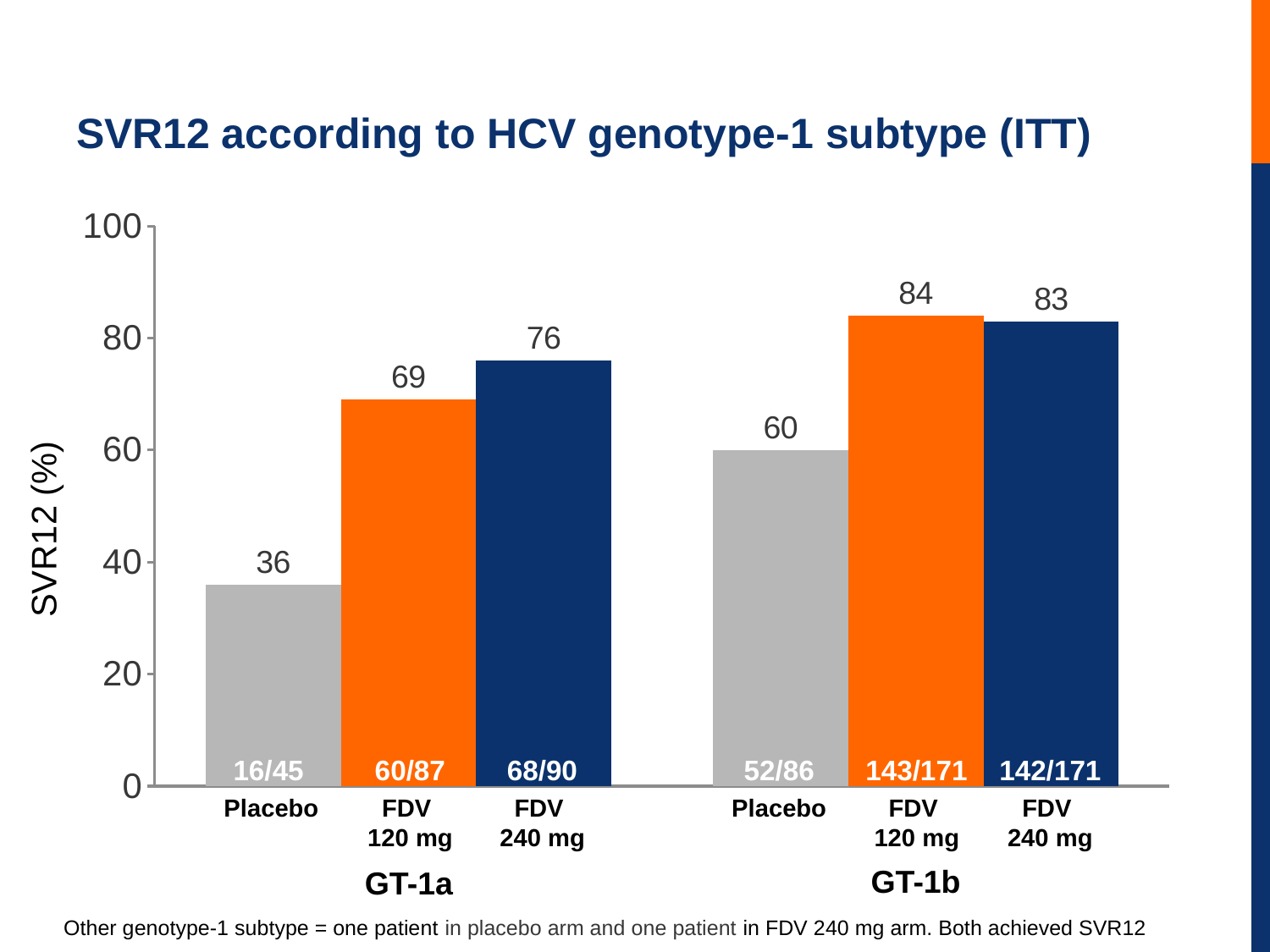
Which bar has the highest SVR12 (%) on the chart? FDV 120 mg, GT-1b Which bar has the lowest SVR12 (%) on the chart? Placebo, GT-1a What fraction of patients is shown inside the FDV 120 mg bar for GT-1b? 143/171 What is the SVR12 (%) for FDV 240 mg in the GT-1b group? 83 What is the difference in SVR12 (%) between FDV 240 mg and Placebo in the GT-1a group? 40 What is the difference in SVR12 (%) between the GT-1b Placebo arm and the GT-1a Placebo arm? 24 How many bars are plotted on the chart? 6 What is the title of the chart on the slide? SVR12 according to HCV genotype-1 subtype (ITT) What is the SVR12 (%) for the Placebo arm in the GT-1a group? 36 What type of chart is shown on the slide? Bar chart What is the SVR12 (%) for FDV 120 mg in the GT-1a group? 69 Which has a higher SVR12 (%): FDV 240 mg in GT-1a or Placebo in GT-1b? FDV 240 mg in GT-1a